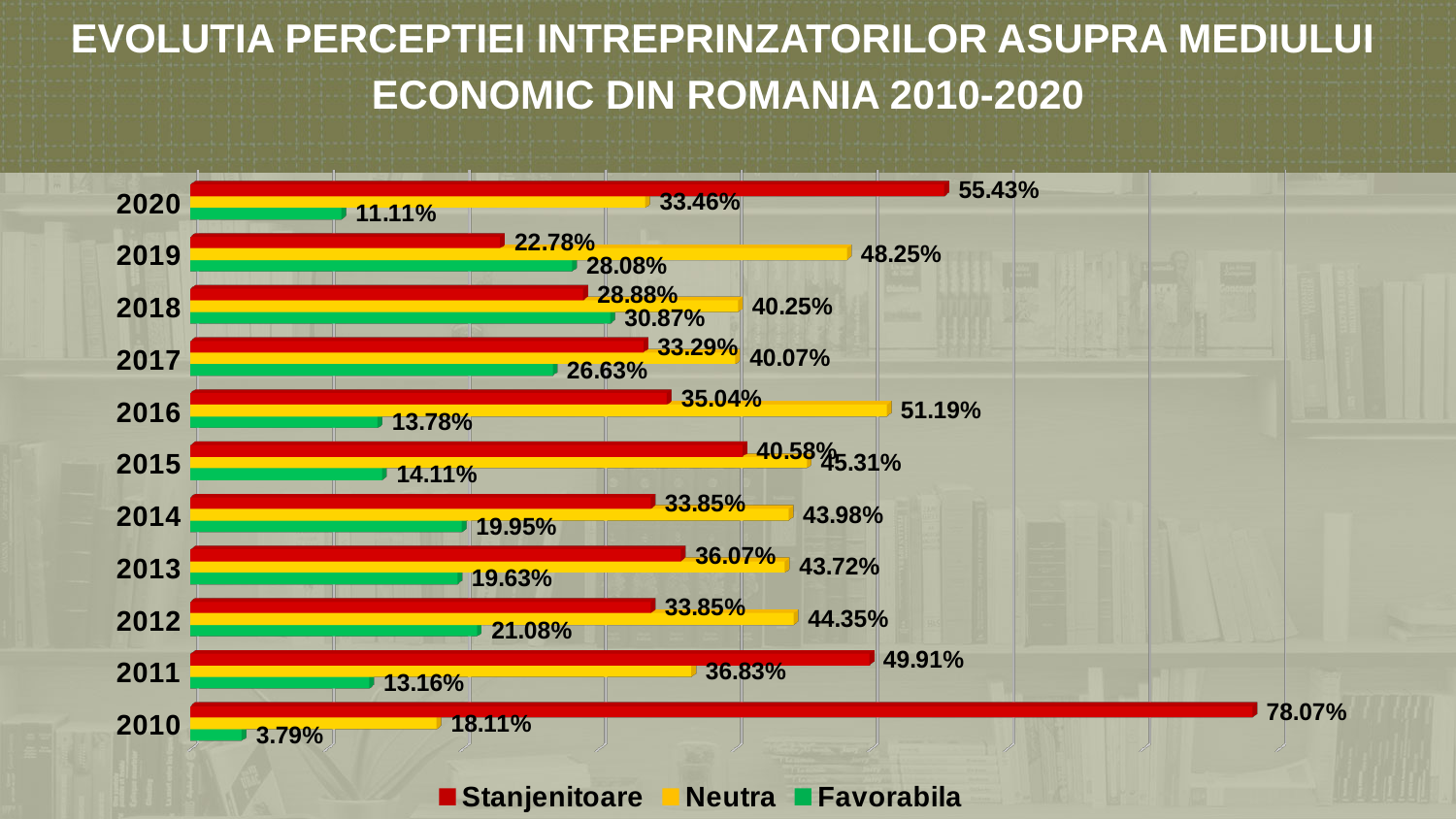
What kind of chart is shown on the slide? Bar chart Which year has the lowest Favorabila value? 2010 Which is larger for 2019, the Neutra value or the Stanjenitoare value? Neutra How many years are shown on the chart? 11 What is the Favorabila value for 2018? 30.87% Which year has the highest Stanjenitoare value? 2010 What is the Neutra value for 2016? 51.19% How many series does the legend list? 3 What is the Stanjenitoare value for 2010? 78.07% What is the difference between the Stanjenitoare and Favorabila values for 2020? 44.32% Which colour represents the Favorabila series? Green Which year has the highest Neutra value? 2016